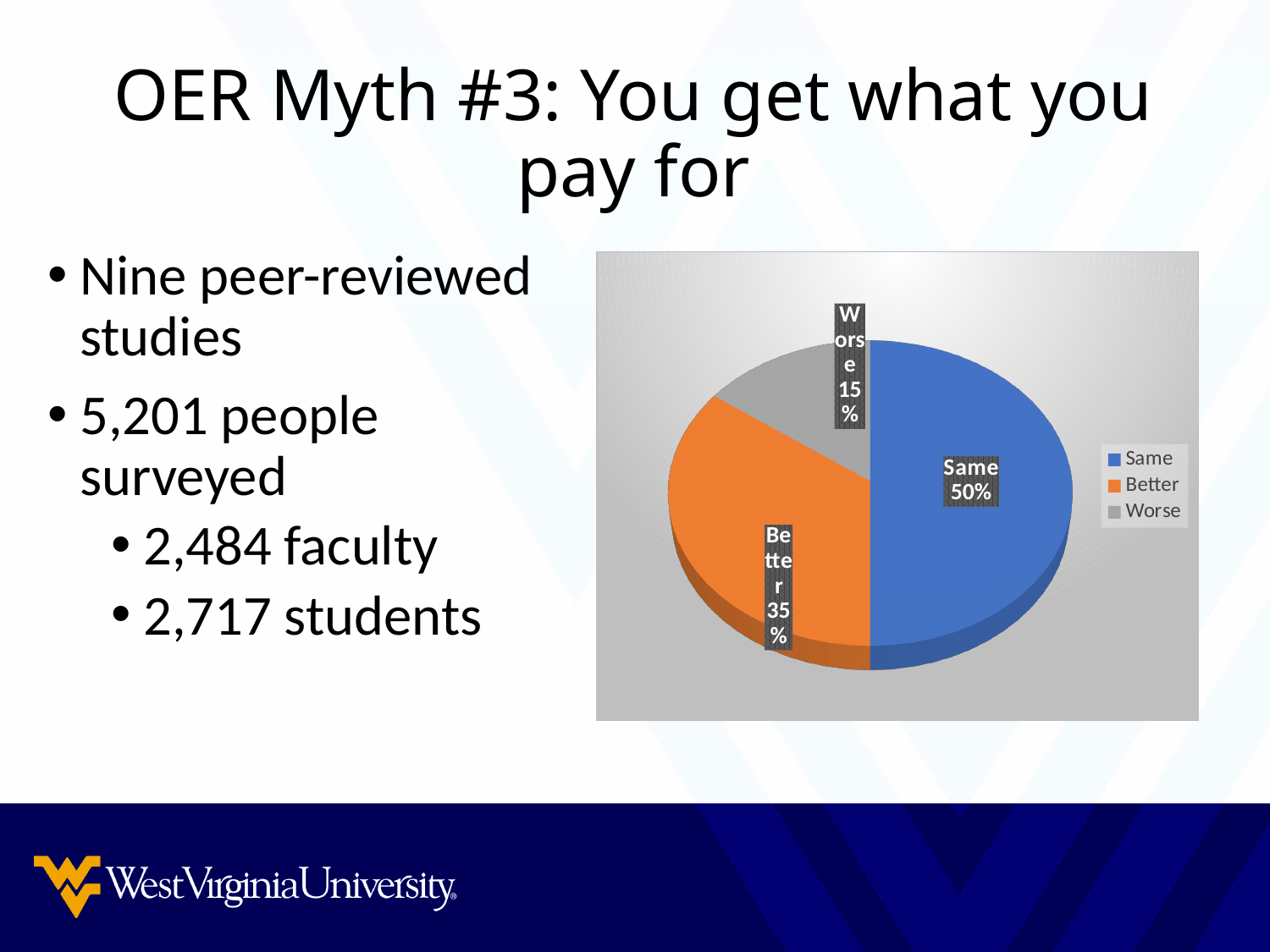
Which is larger, the Better slice or the Worse slice? Better What share of the pie does the Same slice represent? 50% What is the difference in percentage points between the Better and Worse slices? 20 What kind of chart is shown on the slide? pie chart What is the difference in percentage points between the Same and Better slices? 15 What share of the pie does the Worse slice represent? 15% How many slices does the pie chart have? 3 How many entries does the legend list? 3 Which slice of the pie is the largest? Same Which slice of the pie is the smallest? Worse What colour is the Better slice in the pie chart? orange What share of the pie does the Better slice represent? 35%